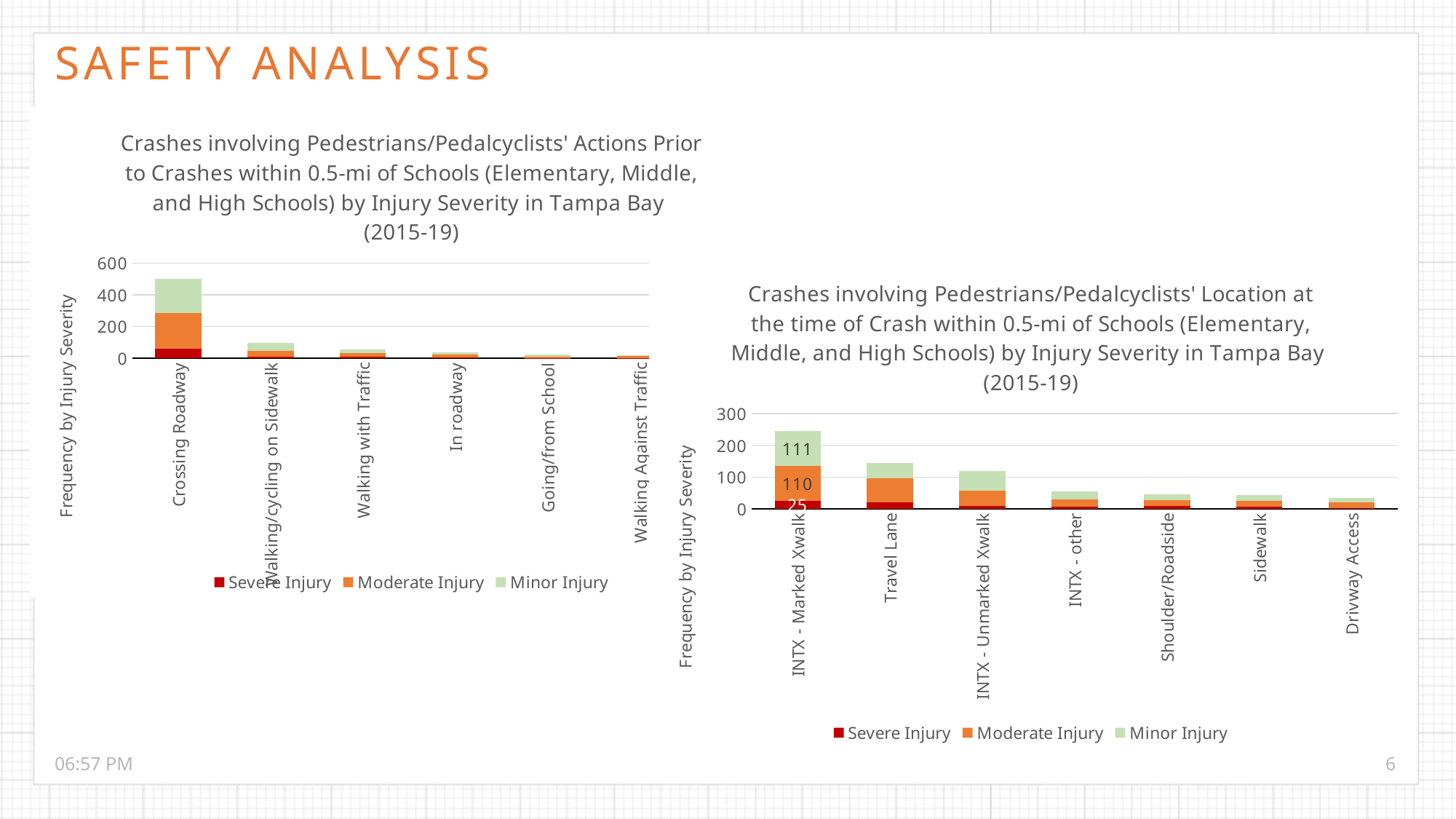
On the left chart (Actions Prior to Crashes), which category has the tallest stacked bar? Crossing Roadway On the right chart (Location at the time of Crash), what is the Minor Injury value for INTX - Marked Xwalk? 111 How many series does the legend of the left chart (Actions Prior to Crashes) list? 3 On the right chart (Location at the time of Crash), what is the difference between the Minor Injury and Severe Injury values for INTX - Marked Xwalk? 86 On the left chart (Actions Prior to Crashes), is the total for Crossing Roadway greater or less than 400? greater How many categories are shown on the right chart (Location at the time of Crash)? 7 On the right chart (Location at the time of Crash), what is the Moderate Injury value for INTX - Marked Xwalk? 110 On the right chart (Location at the time of Crash), what is the total height of the stacked bar for INTX - Marked Xwalk? 246 On the right chart (Location at the time of Crash), what is the Severe Injury value for INTX - Marked Xwalk? 25 On the right chart (Location at the time of Crash), is the total for Travel Lane greater or less than 100? greater On the right chart (Location at the time of Crash), which category has the tallest stacked bar? INTX - Marked Xwalk What type of chart is the left chart (Actions Prior to Crashes)? Stacked bar chart